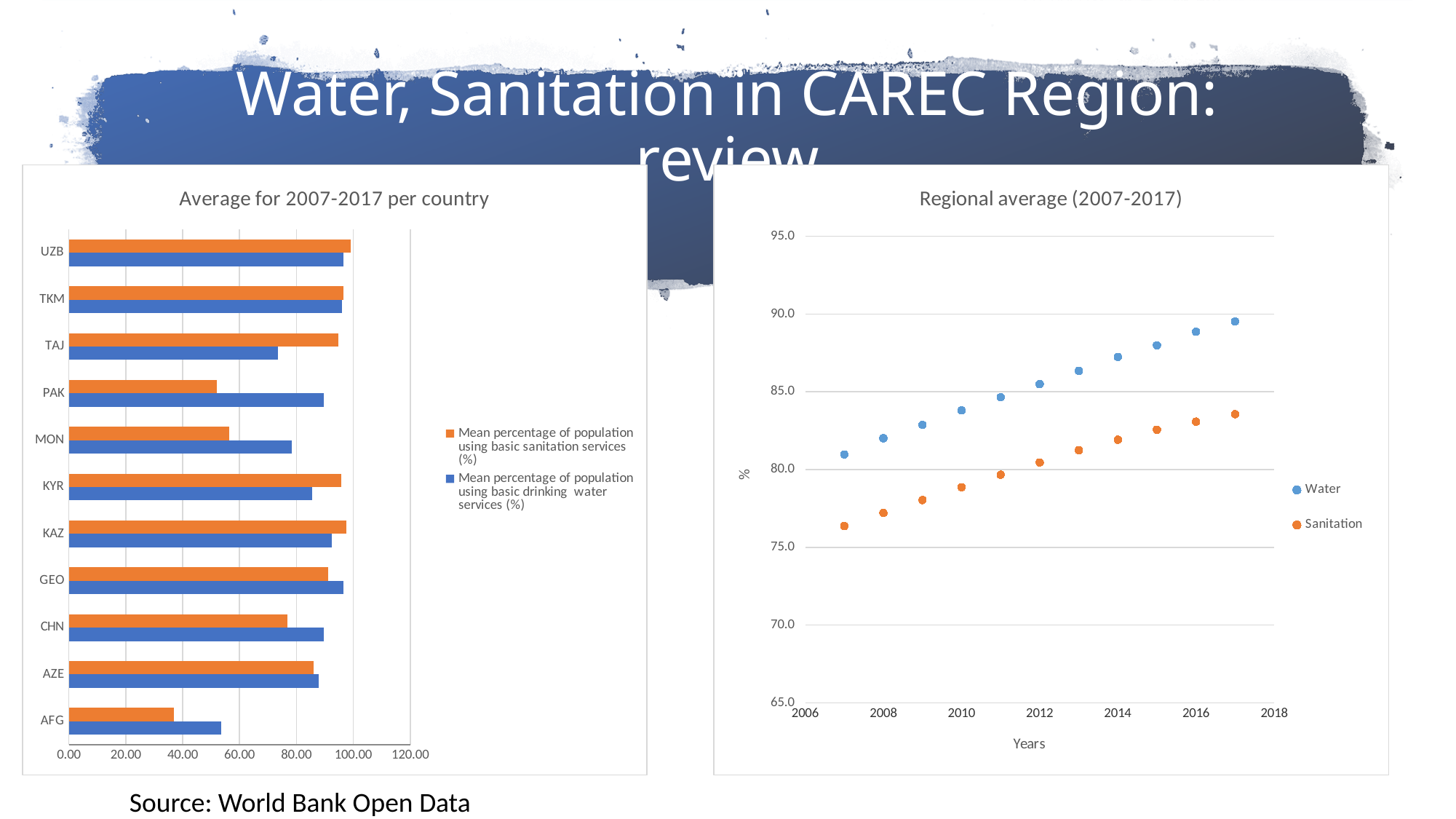
On the right chart 'Regional average (2007-2017)', how many series does the legend list? 2 On the left chart 'Average for 2007-2017 per country', is the value for AZE's basic drinking water services greater or less than 80.00? greater On the left chart 'Average for 2007-2017 per country', for PAK, which is larger: the basic sanitation services value or the basic drinking water services value? basic drinking water services On the left chart 'Average for 2007-2017 per country', which country has the lowest mean percentage of population using basic drinking water services? AFG On the left chart 'Average for 2007-2017 per country', is the value for PAK's basic sanitation services greater or less than 60.00? less How many countries are shown on the left chart 'Average for 2007-2017 per country'? 11 On the right chart 'Regional average (2007-2017)', is the Water value for 2017 greater or less than 85.0? greater What kind of chart is the left chart 'Average for 2007-2017 per country'? bar chart On the left chart 'Average for 2007-2017 per country', for TAJ, which is larger: the basic sanitation services value or the basic drinking water services value? basic sanitation services On the right chart 'Regional average (2007-2017)', do the Water values rise or fall from 2007 to 2017? rise On the left chart 'Average for 2007-2017 per country', which country has the lowest mean percentage of population using basic sanitation services? AFG